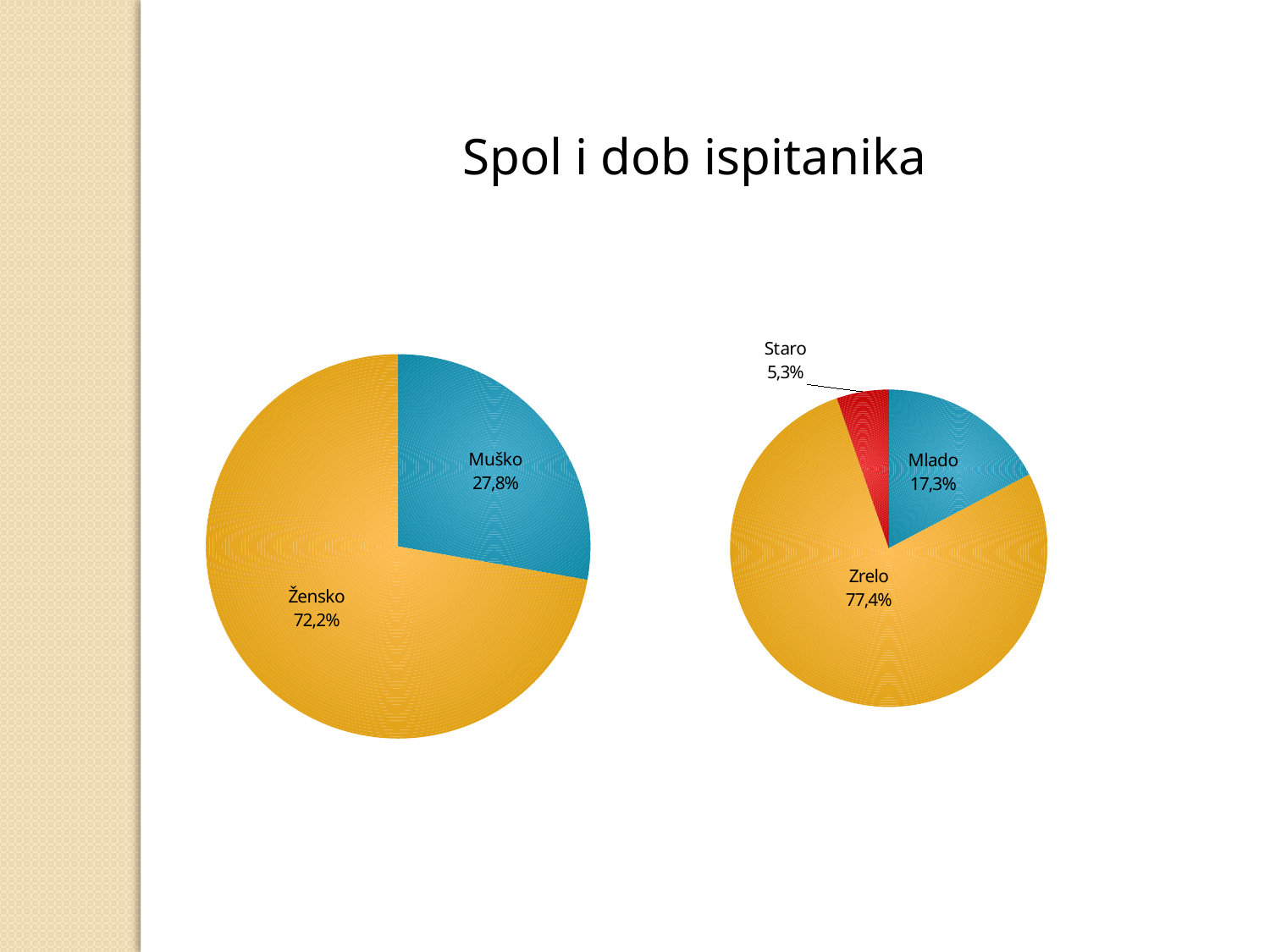
How many slices does the right pie chart have? 3 In the right pie chart, which category has the largest slice? Zrelo In the left pie chart, what is the difference in percentage points between Žensko and Muško? 44,4 In the right pie chart, what is the difference in percentage points between Mlado and Staro? 12,0 In the left pie chart, what share is labelled for Muško? 27,8% What type of chart is the left chart on the slide? Pie chart In the right pie chart, what share is labelled for Staro? 5,3% In the left pie chart, what share is labelled for Žensko? 72,2% In the right pie chart, which category has the smallest slice? Staro In the left pie chart, which slice is larger, Žensko or Muško? Žensko In the right pie chart, what share is labelled for Zrelo? 77,4% In the right pie chart, what share is labelled for Mlado? 17,3%